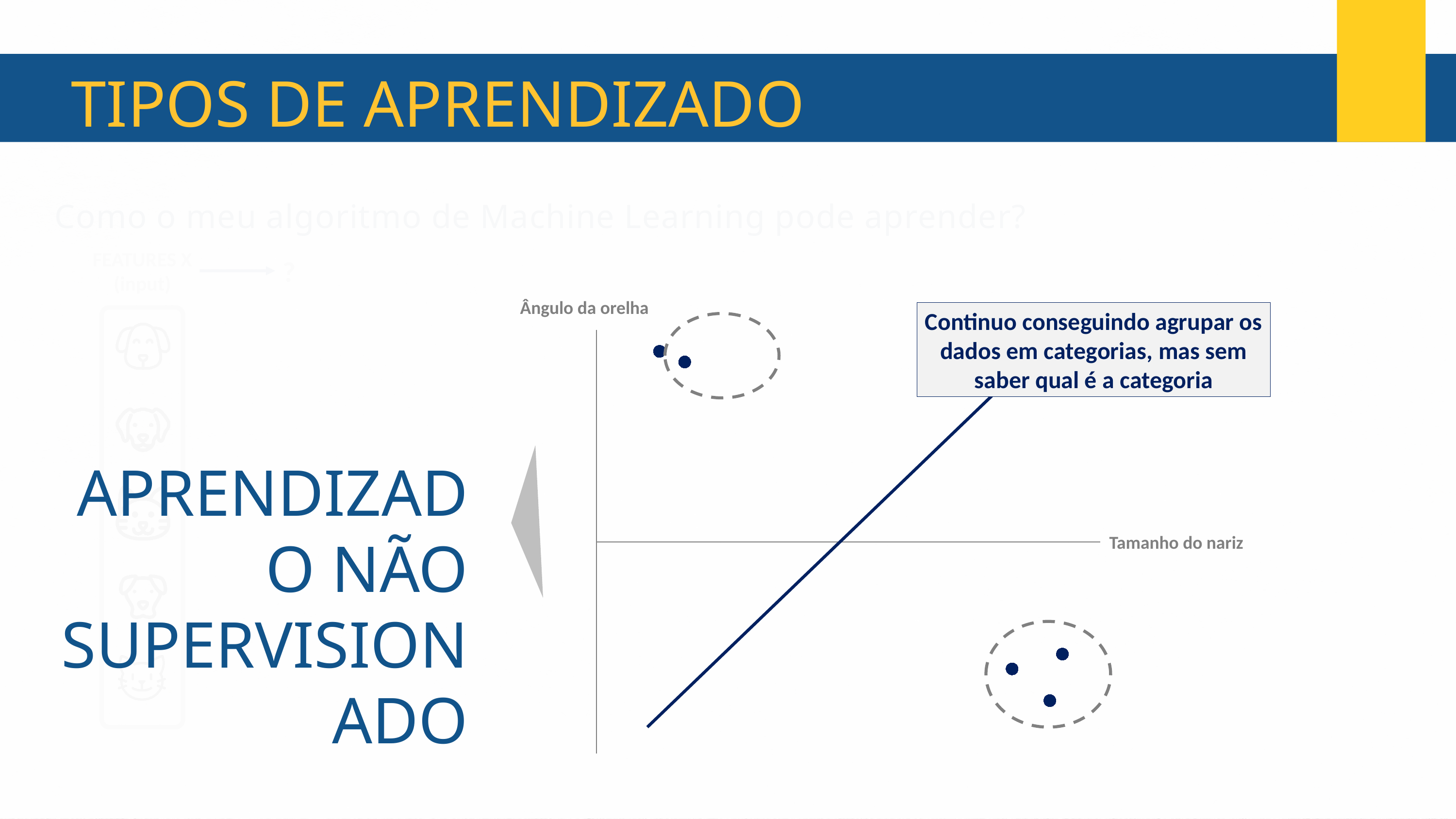
What is the label of the vertical axis of the chart? Ângulo da orelha How many dashed-circle groups (clusters) are drawn around the points on the chart? 2 What is the label of the horizontal axis of the chart? Tamanho do nariz Do the points in the upper-left cluster have higher or lower 'Ângulo da orelha' values than the points in the lower-right cluster? Higher Which cluster contains more points, the upper-left one or the lower-right one? Lower-right Do the points in the lower-right cluster have larger or smaller values on the 'Tamanho do nariz' axis than the points in the upper-left cluster? Larger How many points are inside the upper-left dashed cluster? 2 How many points are inside the lower-right dashed cluster? 3 What kind of chart is shown on the slide? Scatter plot